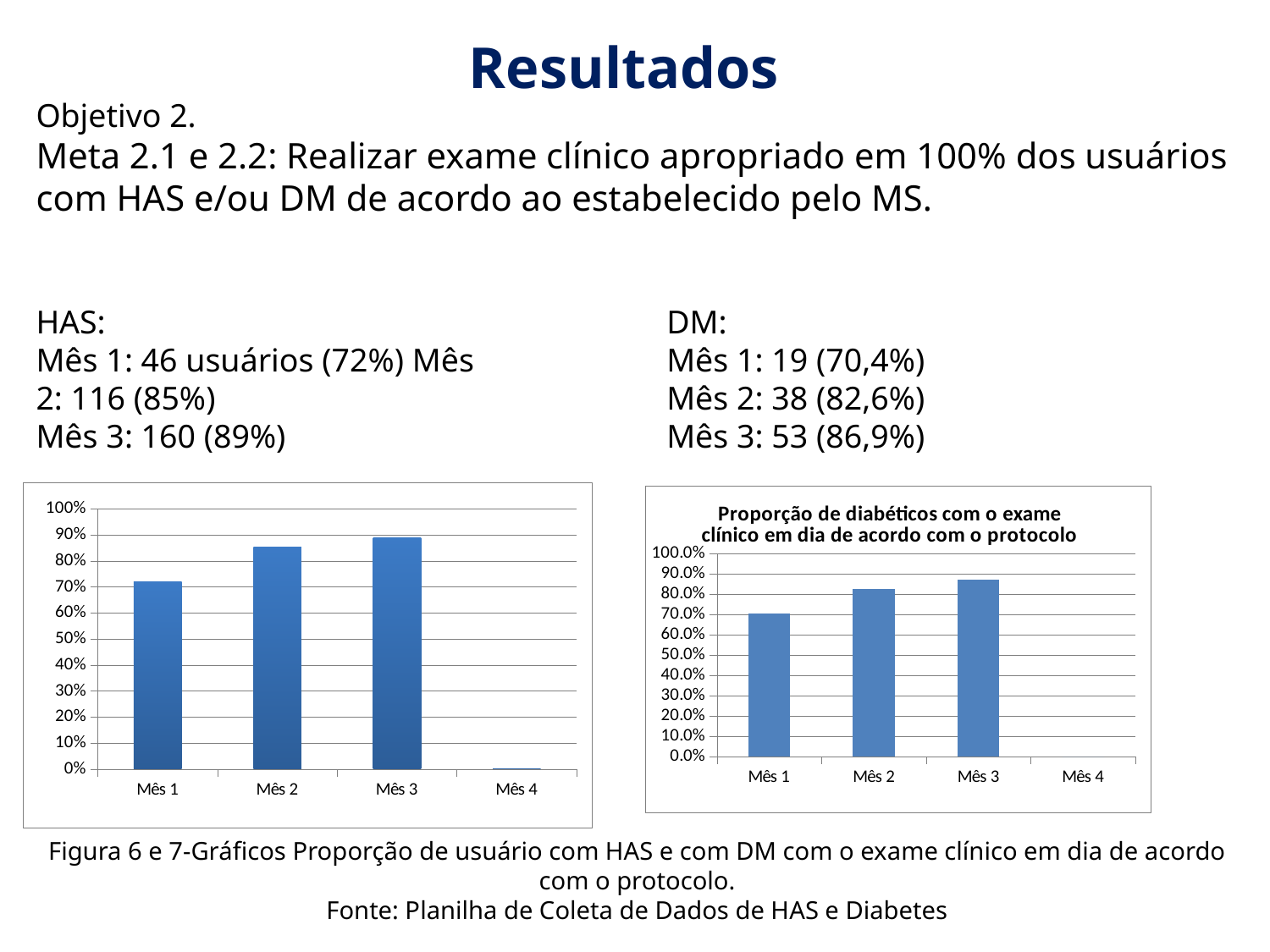
In the right chart (diabéticos), do the values rise or fall from Mês 1 to Mês 3? rise What is the title of the right chart? Proporção de diabéticos com o exame clínico em dia de acordo com o protocolo In the left chart (HAS), is the value for Mês 2 greater or less than 80%? greater How many categories are shown on the x axis of the right chart (diabéticos)? 4 In the left chart (HAS), is the value for Mês 1 greater or less than 80%? less In the right chart (diabéticos), which month has the highest bar? Mês 3 In the left chart (HAS), which month has the highest bar? Mês 3 How many categories are shown on the x axis of the left chart (HAS)? 4 What type of chart is the right chart titled 'Proporção de diabéticos com o exame clínico em dia de acordo com o protocolo'? bar chart In the right chart (diabéticos), is the value for Mês 1 greater or less than 60.0%? greater In the left chart (HAS), which month has the lowest bar? Mês 4 What type of chart is the left chart (HAS)? bar chart